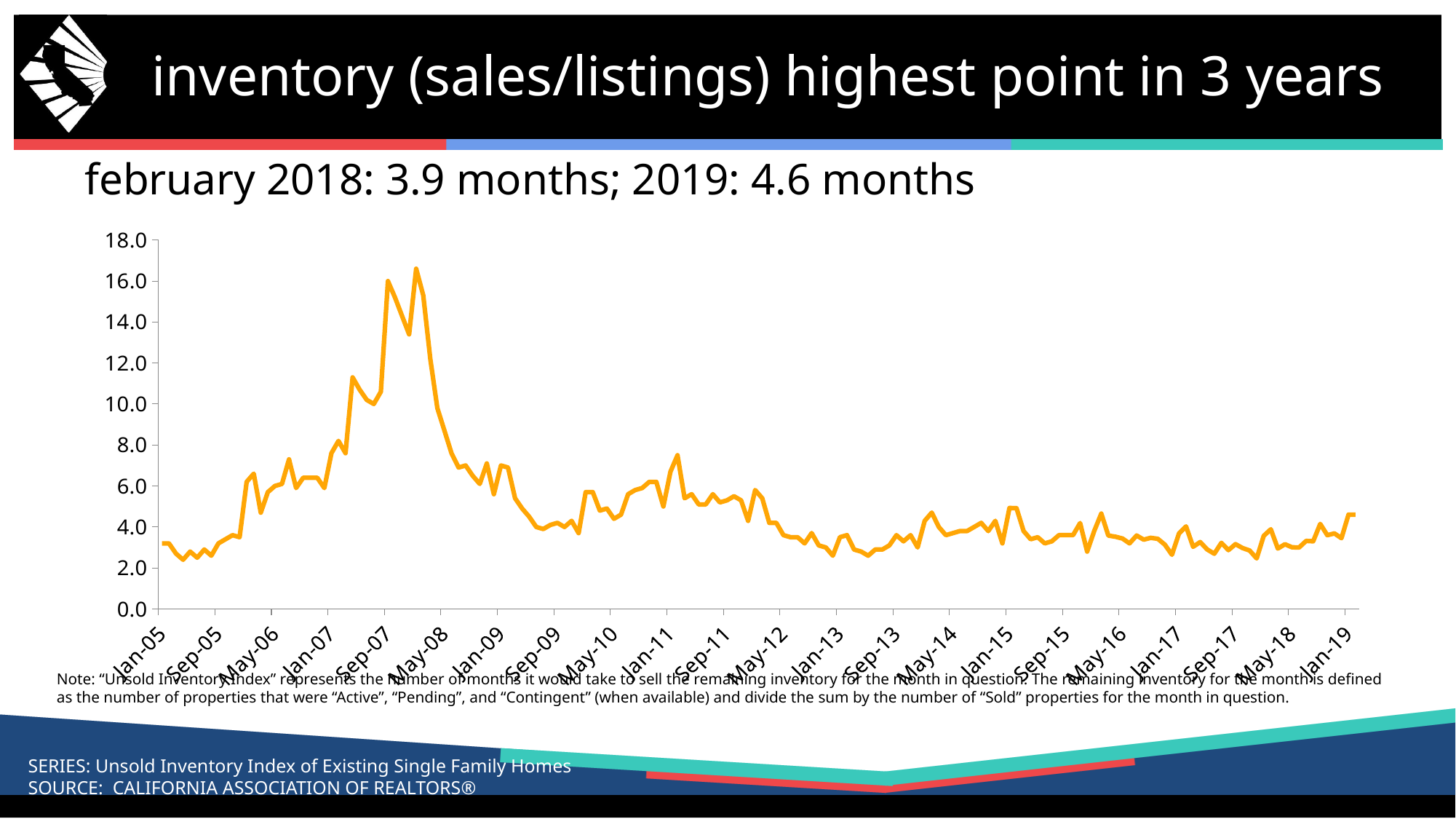
Does the line rise or fall between Sep-07 and Jan-09? fall Is the value at Jan-05 greater or less than 4.0? less What colour is the plotted line? orange What is the highest value shown on the vertical axis? 18.0 According to the slide, what was the unsold inventory value for February 2018? 3.9 months What kind of chart is shown on the slide? line chart Is the highest value reached around Jan-11 greater or less than 6.0? greater Which February value is larger, 2018 or 2019? 2019 By how many months did the February value rise from 2018 to 2019? 0.7 months In which year does the line reach its highest point? 2008 According to the slide, what was the unsold inventory value for February 2019? 4.6 months Is the peak value of the line in 2008 greater or less than 16.0? greater